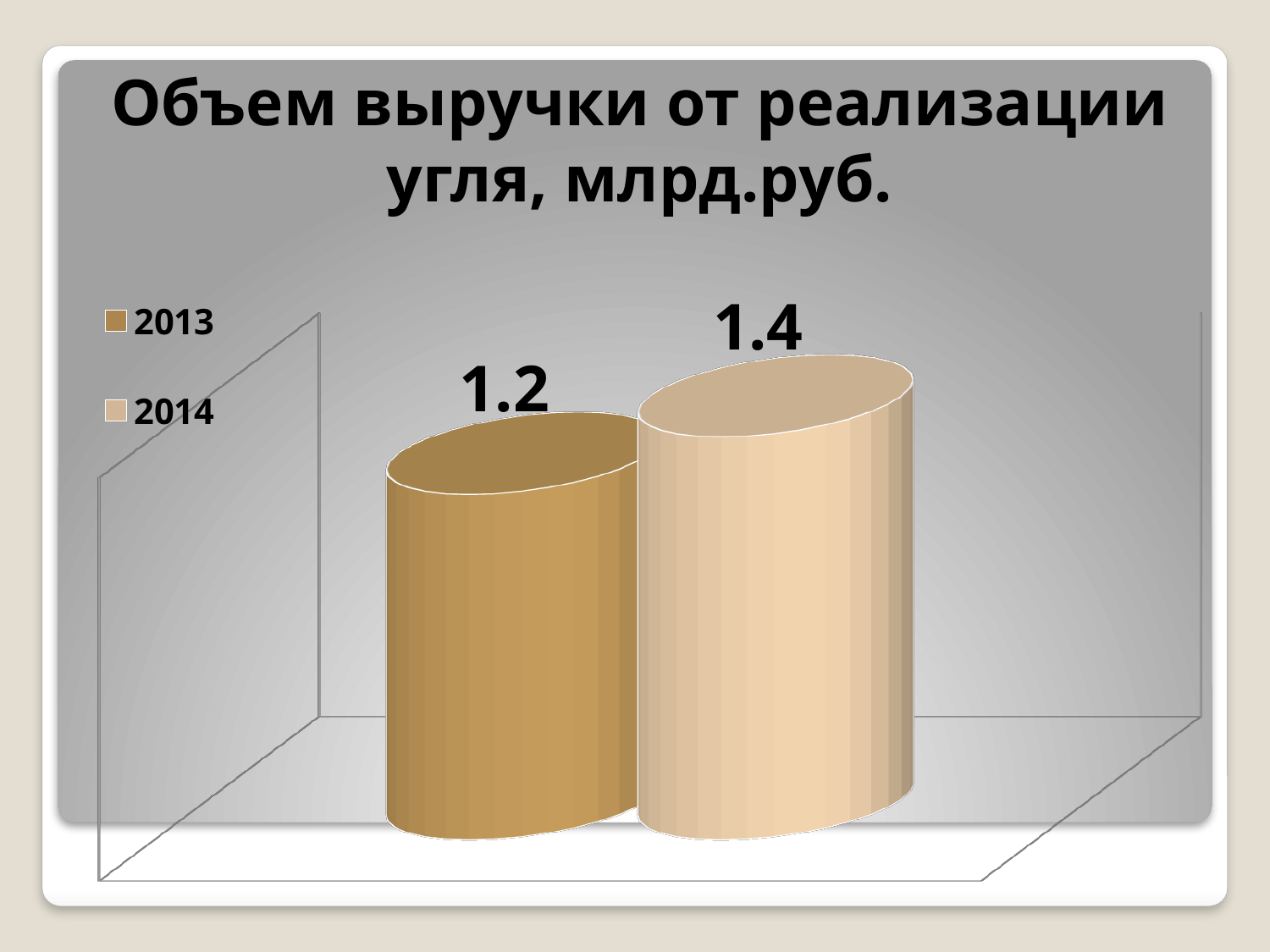
What is the value for 2014? 1.4 What is the difference between the 2014 and 2013 values? 0.2 What is the value for 2013? 1.2 What kind of chart is shown on the slide? Bar chart Which year has the lower revenue value? 2013 How many series does the legend list? 2 Which year has the higher revenue value? 2014 Do the values rise or fall from 2013 to 2014? Rise What is the title of the chart? Объем выручки от реализации угля, млрд.руб. What unit is stated in the chart title? млрд.руб. Is the value for 2014 larger than the value for 2013? Yes